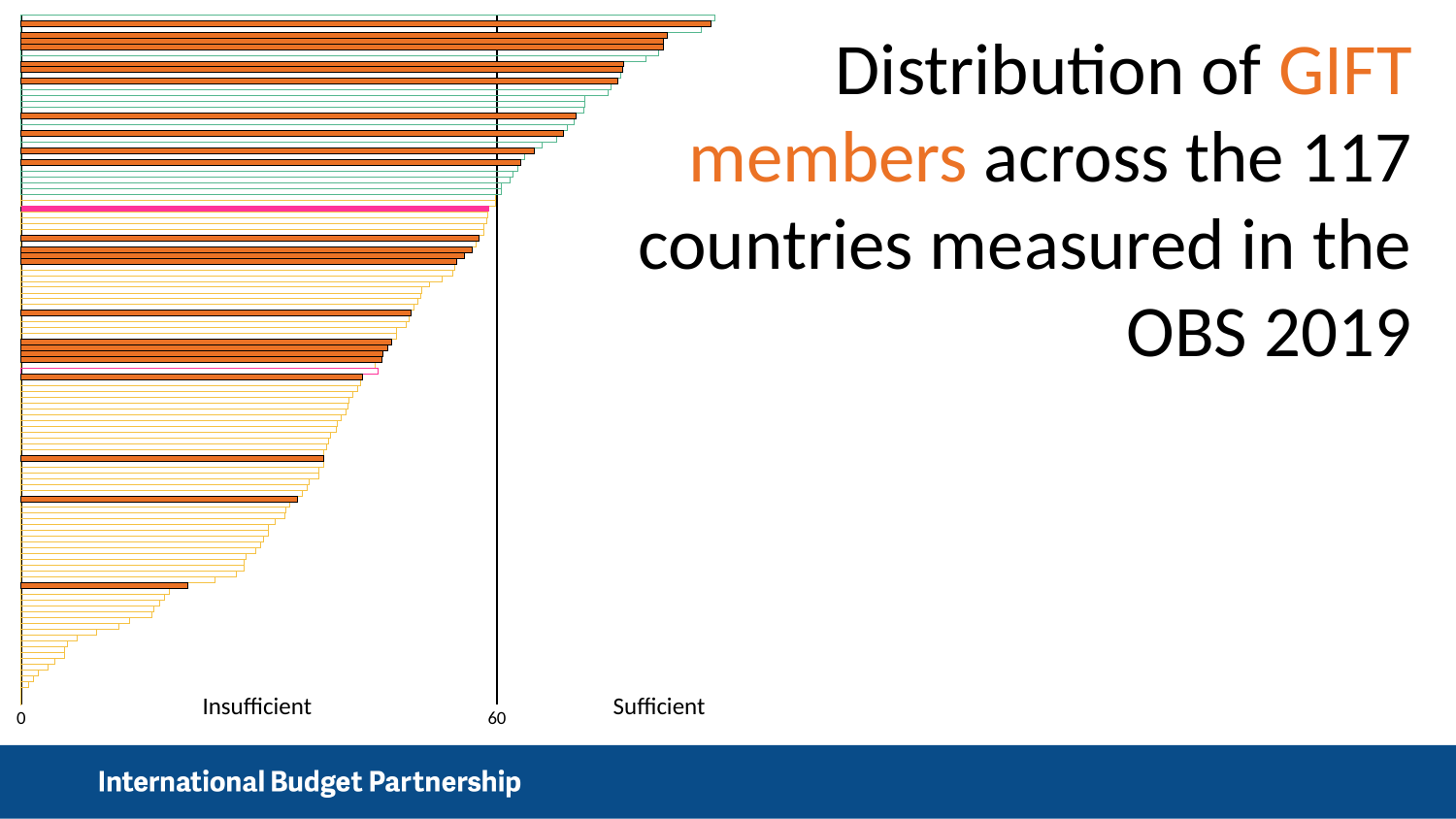
What is the lowest value shown on the x axis? 0 Is the value of the longest (topmost) bar greater or less than 60? greater What label appears on the x axis to the left of the 60 line? Insufficient Is the value of the shortest (bottom) bar greater or less than 60? less Do the bar values increase or decrease going from the top of the chart to the bottom? decrease According to the chart title, how many countries are measured in the OBS 2019? 117 What kind of chart is shown on the slide? bar chart What value does the vertical reference line on the chart mark on the x axis? 60